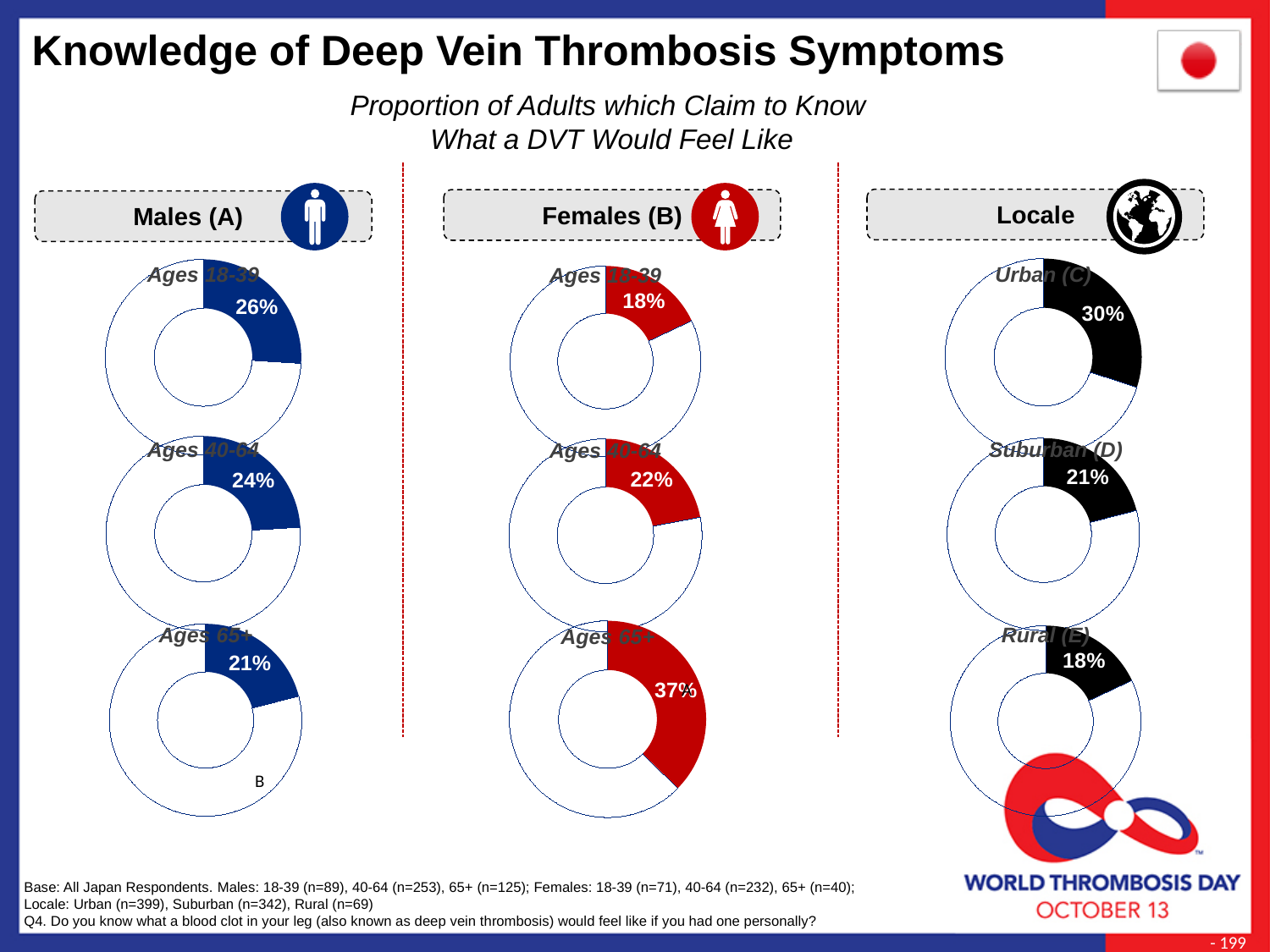
Which is larger: the Males (A) Ages 40-64 value or the Females (B) Ages 40-64 value? Males (A) Ages 40-64 Among the three Females (B) donut charts, which age group has the highest value? Ages 65+ What is the difference between the Females (B) Ages 65+ value and the Males (A) Ages 65+ value? 16% In the Locale column, what percentage is shown for Urban (C)? 30% In the Locale column, what is the value for Rural (E)? 18% How many donut charts are shown on the slide in total? 9 What is the difference between the Urban (C) and Suburban (D) values in the Locale column? 9% Among the three Males (A) donut charts, which age group has the lowest value? Ages 65+ What type of chart is used to show each proportion on this slide? Donut chart In the Males (A) column, what percentage of adults aged 18-39 claim to know what a DVT would feel like? 26% In the Females (B) column, what is the value shown for Ages 65+? 37% Among the three Locale donut charts, which locale has the lowest value? Rural (E)